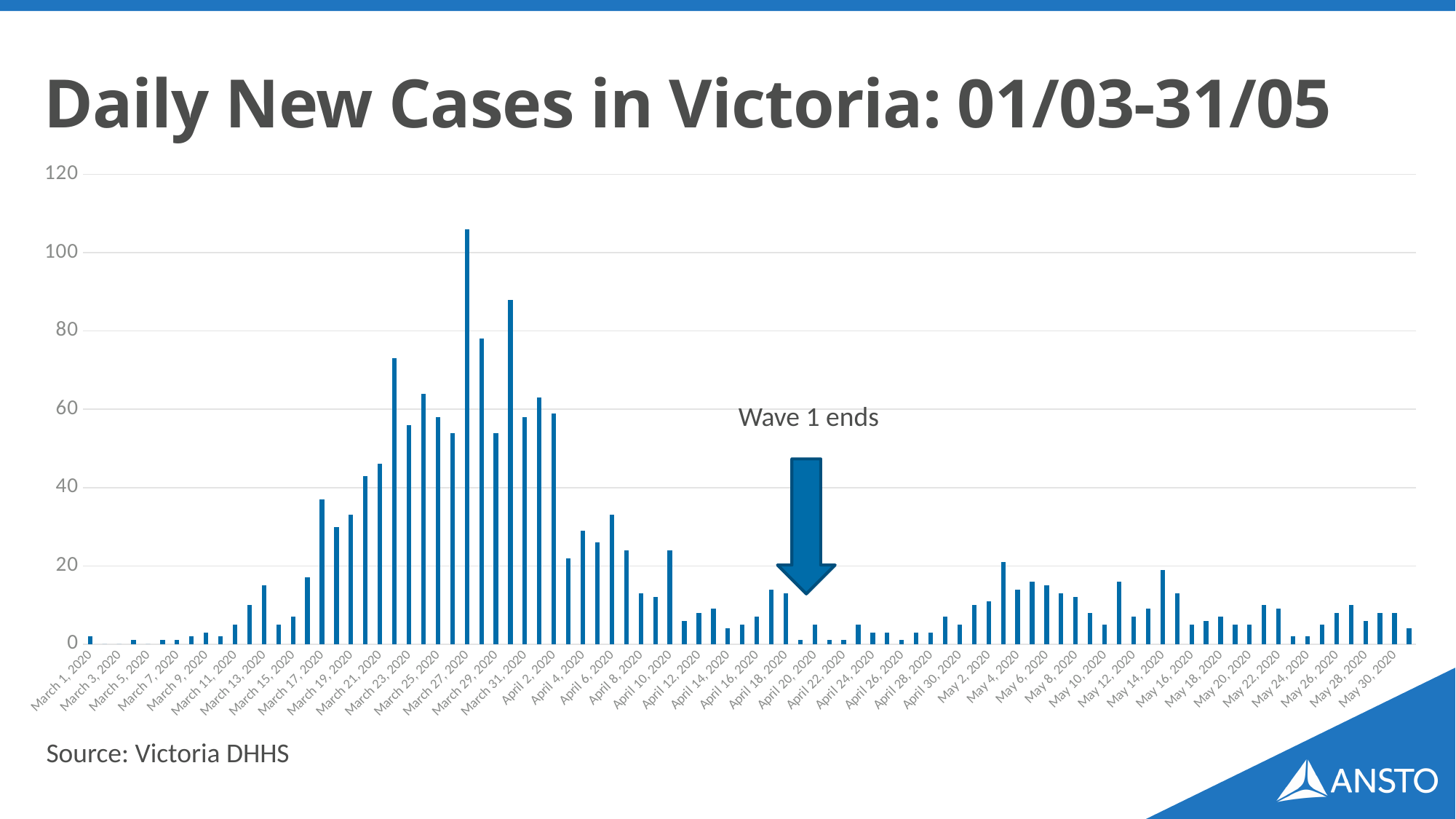
Is the value for April 26, 2020 greater or less than 20? less Is the value for March 1, 2020 greater or less than 20? less Is the value for May 4, 2020 greater or less than 40? less Do the daily values generally rise or fall from the end of March to the end of April? fall What does the annotation with the arrow on the chart say? Wave 1 ends Which has the larger value, March 31, 2020 or March 1, 2020? March 31, 2020 What kind of chart is shown on the slide? bar chart What is the title of the chart? Daily New Cases in Victoria: 01/03-31/05 In which month does the highest daily value on the chart occur? March